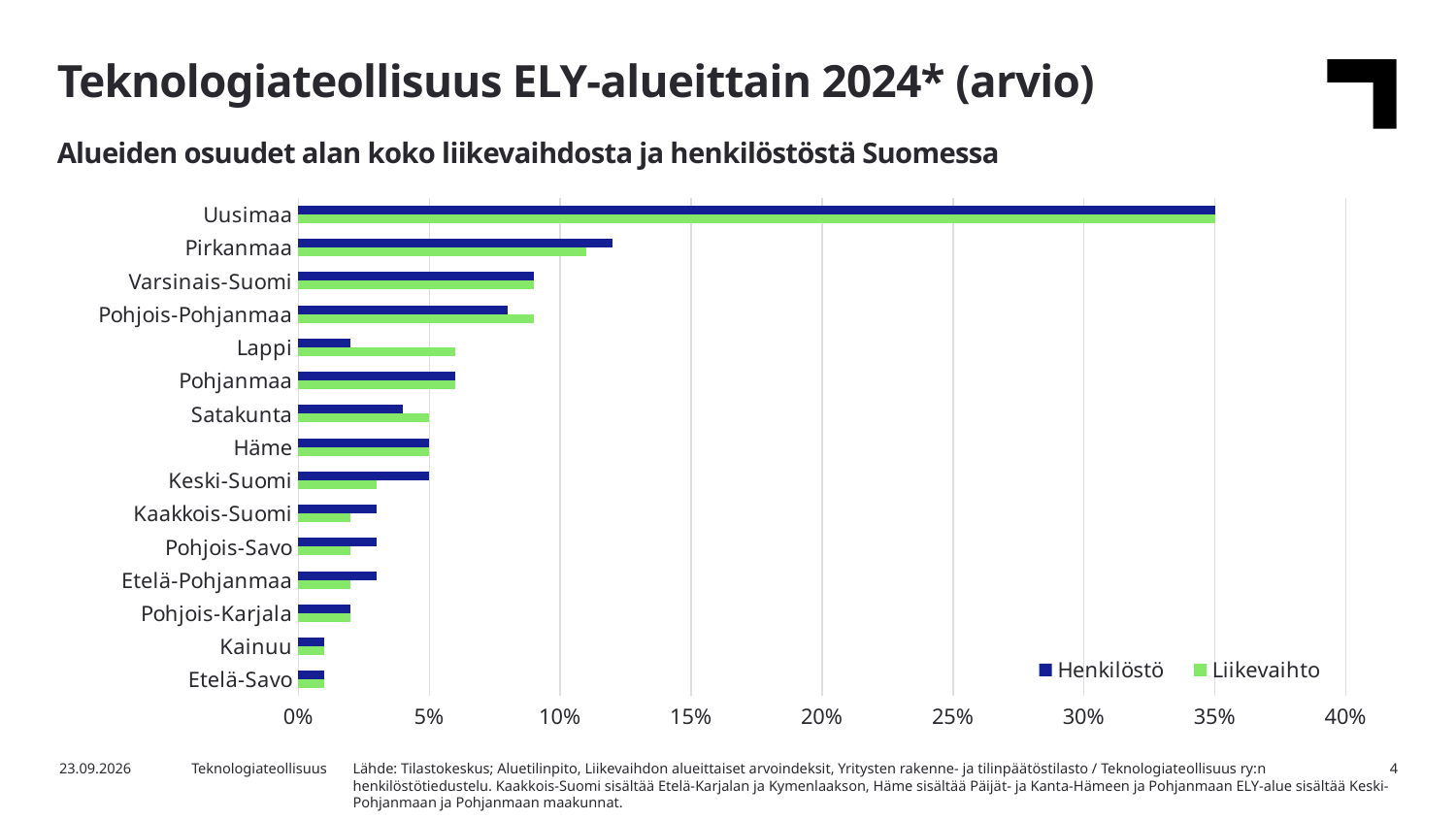
Is the Henkilöstö value for Uusimaa greater or less than 30%? greater How many series does the legend list? 2 Which region has the highest Liikevaihto share? Uusimaa For Lappi, which is larger: the Henkilöstö share or the Liikevaihto share? Liikevaihto Which region has the highest Henkilöstö share? Uusimaa Is the Henkilöstö value for Varsinais-Suomi greater or less than 10%? less Which colour represents the Liikevaihto series in the legend? green Is the Henkilöstö value for Lappi greater or less than 5%? less For Keski-Suomi, which is larger: the Henkilöstö share or the Liikevaihto share? Henkilöstö What kind of chart is shown on the slide? bar chart How many regions (categories) are shown on the chart? 15